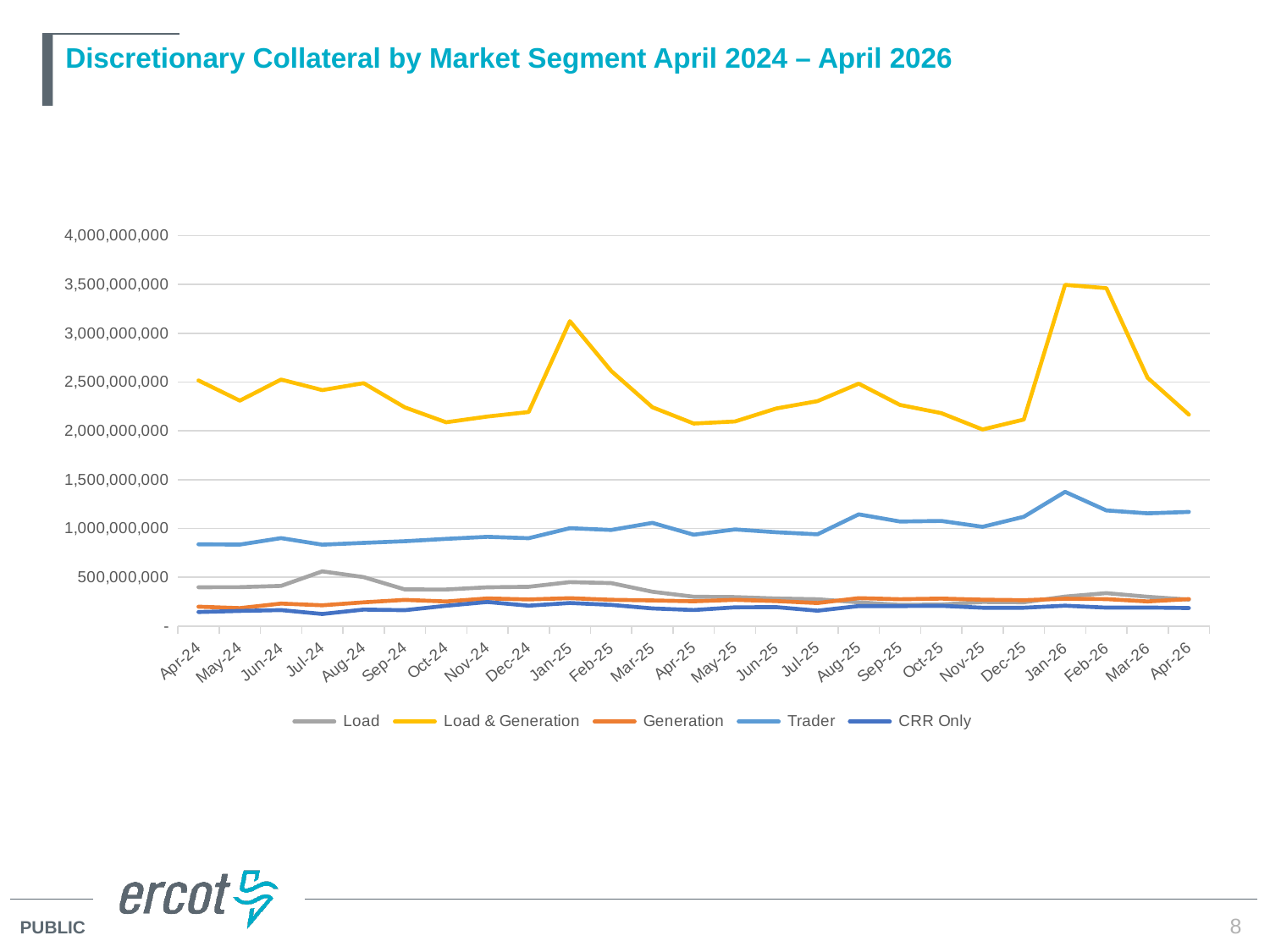
What kind of chart is shown on the slide? Line chart Is the value for Load & Generation in Nov-25 greater or less than 2,500,000,000? less Is the value for Trader in Apr-24 greater or less than 1,000,000,000? less In Apr-26, which is larger: the value for Trader or the value for Load? Trader Which market segment has the lowest discretionary collateral across the whole period? CRR Only How many months are plotted along the x axis? 25 What is the title of the chart? Discretionary Collateral by Market Segment April 2024 – April 2026 Is the value for Load in Apr-24 greater or less than 500,000,000? less Which market segment has the highest discretionary collateral across the whole period? Load & Generation How many series does the legend list? 5 Does the Load & Generation line rise or fall from Feb-26 to Apr-26? Fall